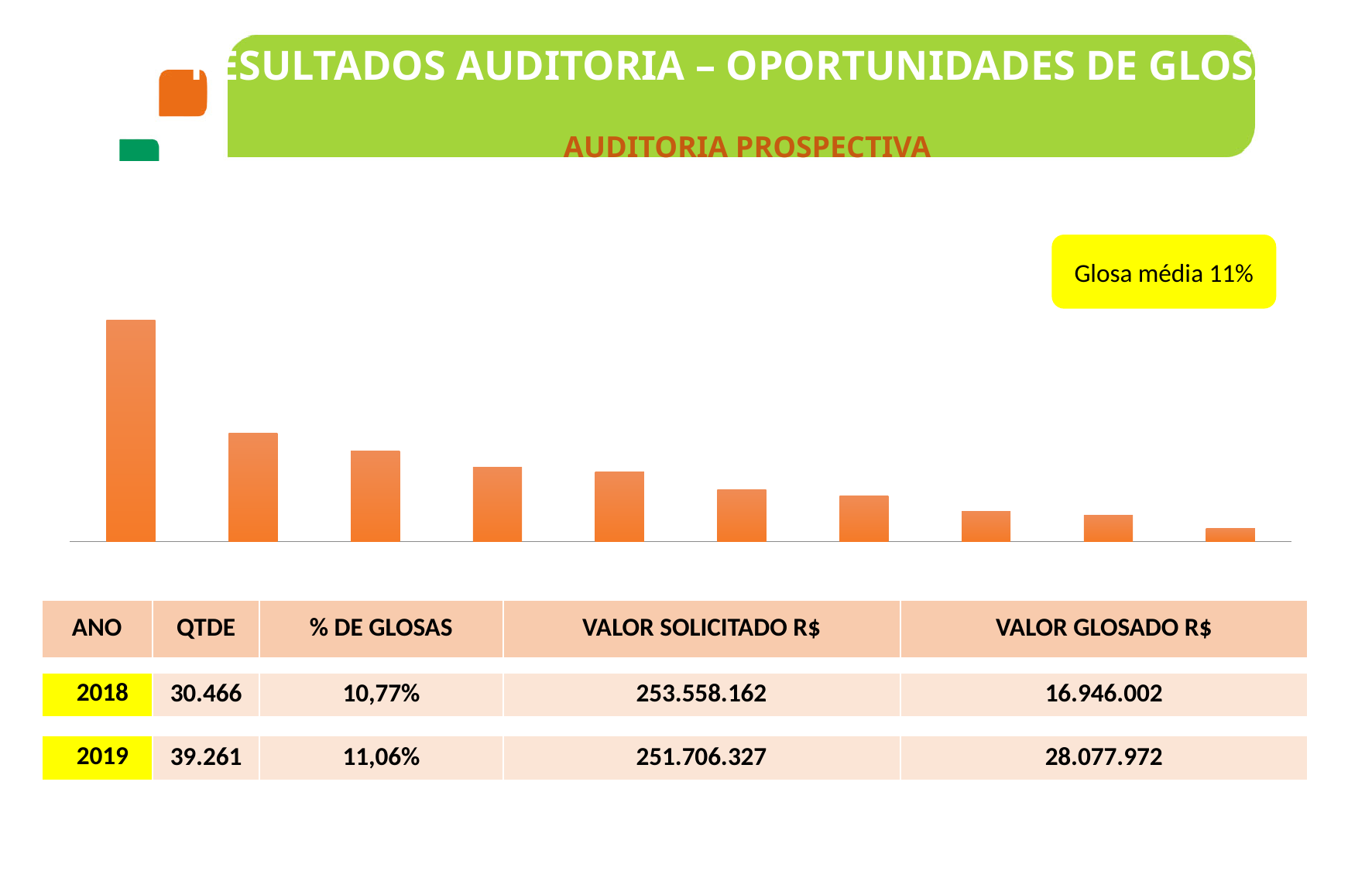
Is the leftmost bar taller or shorter than the second bar from the left? taller Does the chart display a legend? No Do the bar values rise or fall from left to right across the chart? fall What colour are the bars in the chart? orange How many bars does the chart contain? 10 Is the second bar from the right taller or shorter than the rightmost bar? taller Which bar in the chart is the shortest, by position? the rightmost bar What kind of chart is shown on the slide? bar chart Which bar in the chart is the tallest, by position? the leftmost bar